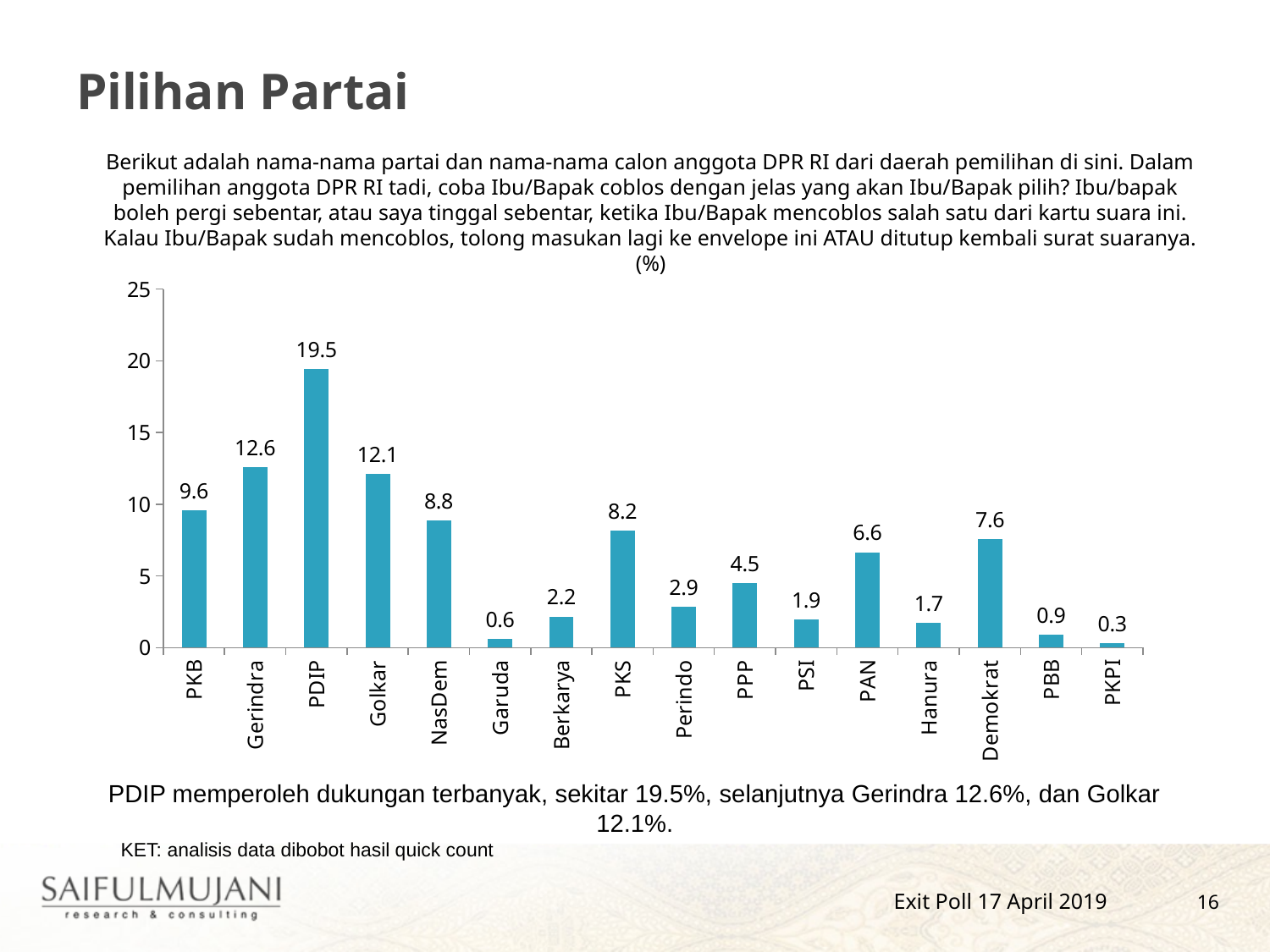
What is the value for PDIP? 19.5 What kind of chart is shown on the slide? bar chart What is the value for NasDem? 8.8 Which party has the lowest value? PKPI What is the difference between the values for PDIP and PKB? 9.9 Which is larger, the value for PAN or the value for PPP? PAN What is the title of the slide? Pilihan Partai How many parties are shown on the x axis? 16 What is the value for Hanura? 1.7 Which party has the highest value? PDIP Which is larger, the value for PKS or the value for Demokrat? PKS What is the difference between the values for Gerindra and Golkar? 0.5